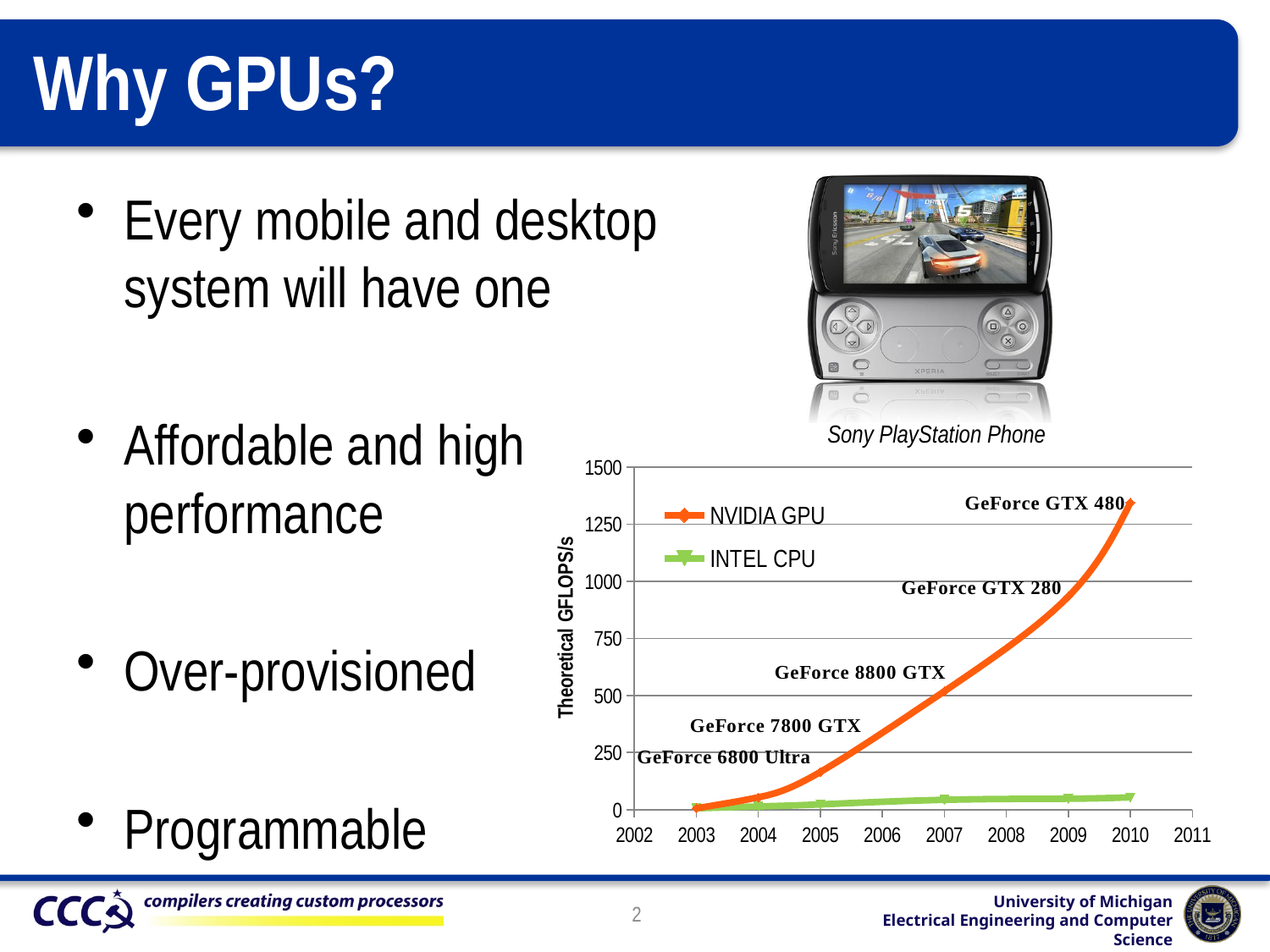
Is the NVIDIA GPU value in 2010 greater or less than 1000? greater Is the INTEL CPU value in 2010 greater or less than 250? less What kind of chart is shown on the slide? line chart Does the NVIDIA GPU line rise or fall from 2003 to 2010? rise What are the two series named in the chart's legend? NVIDIA GPU and INTEL CPU How many series does the chart's legend list? 2 In 2010, which series has the higher value, NVIDIA GPU or INTEL CPU? NVIDIA GPU How many GeForce products are labelled along the NVIDIA GPU line? 5 What is the label on the chart's vertical axis? Theoretical GFLOPS/s Is the NVIDIA GPU value in 2003 greater or less than 250? less Which labelled GeForce product sits at the highest point on the NVIDIA GPU line? GeForce GTX 480